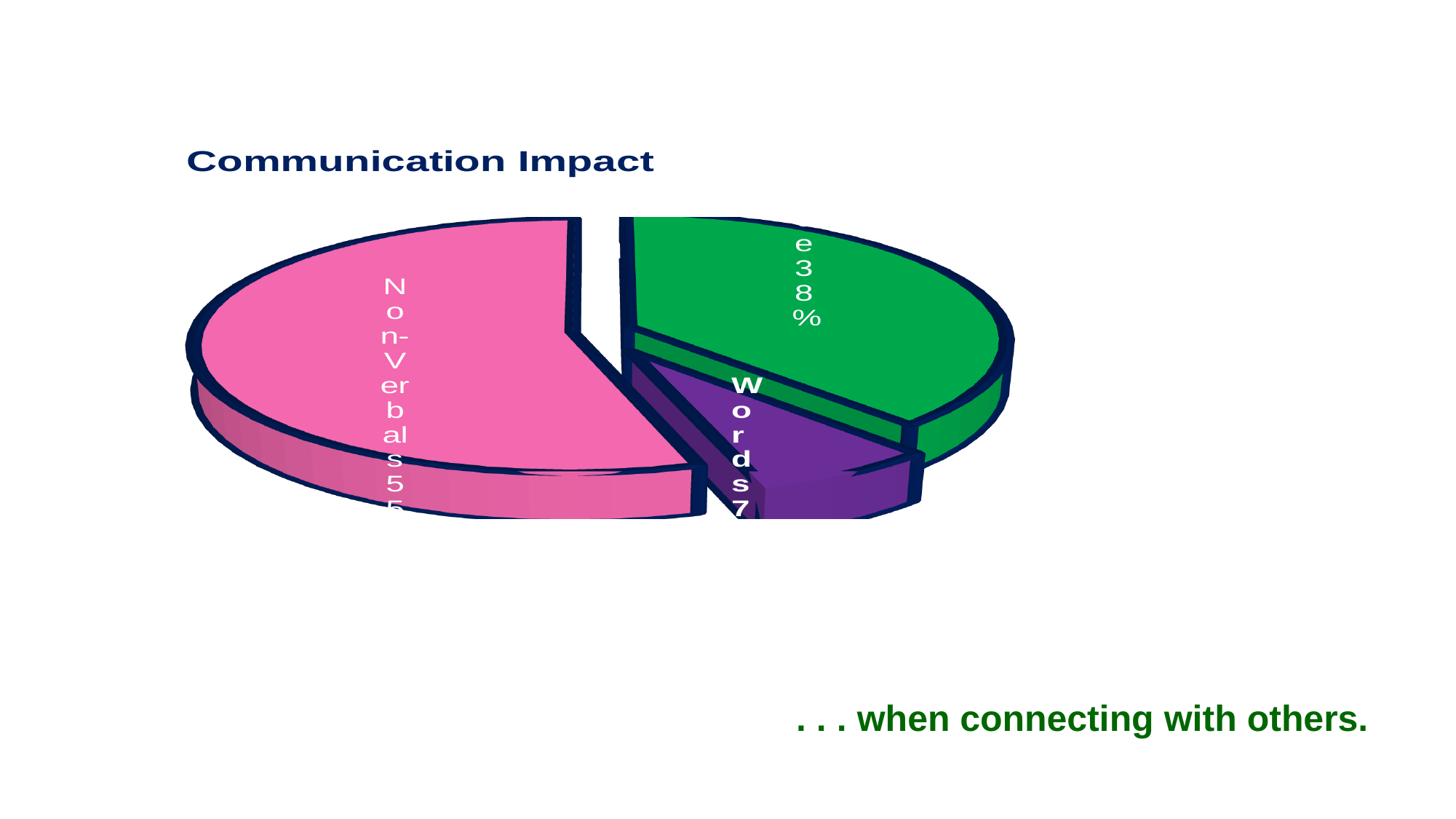
How many slices does the pie chart have? 3 What is the title of the pie chart? Communication Impact What colour is the Non-Verbals slice? pink Which slice is larger, the green slice or the Words slice? the green slice Which slice is larger, Non-Verbals or Words? Non-Verbals Which slice of the pie chart is the largest? Non-Verbals What percentage is printed on the green slice of the pie chart? 38% Does the Non-Verbals slice take up more or less than half of the pie? more What kind of chart is shown on the slide? pie chart Which slice of the pie chart is the smallest? Words